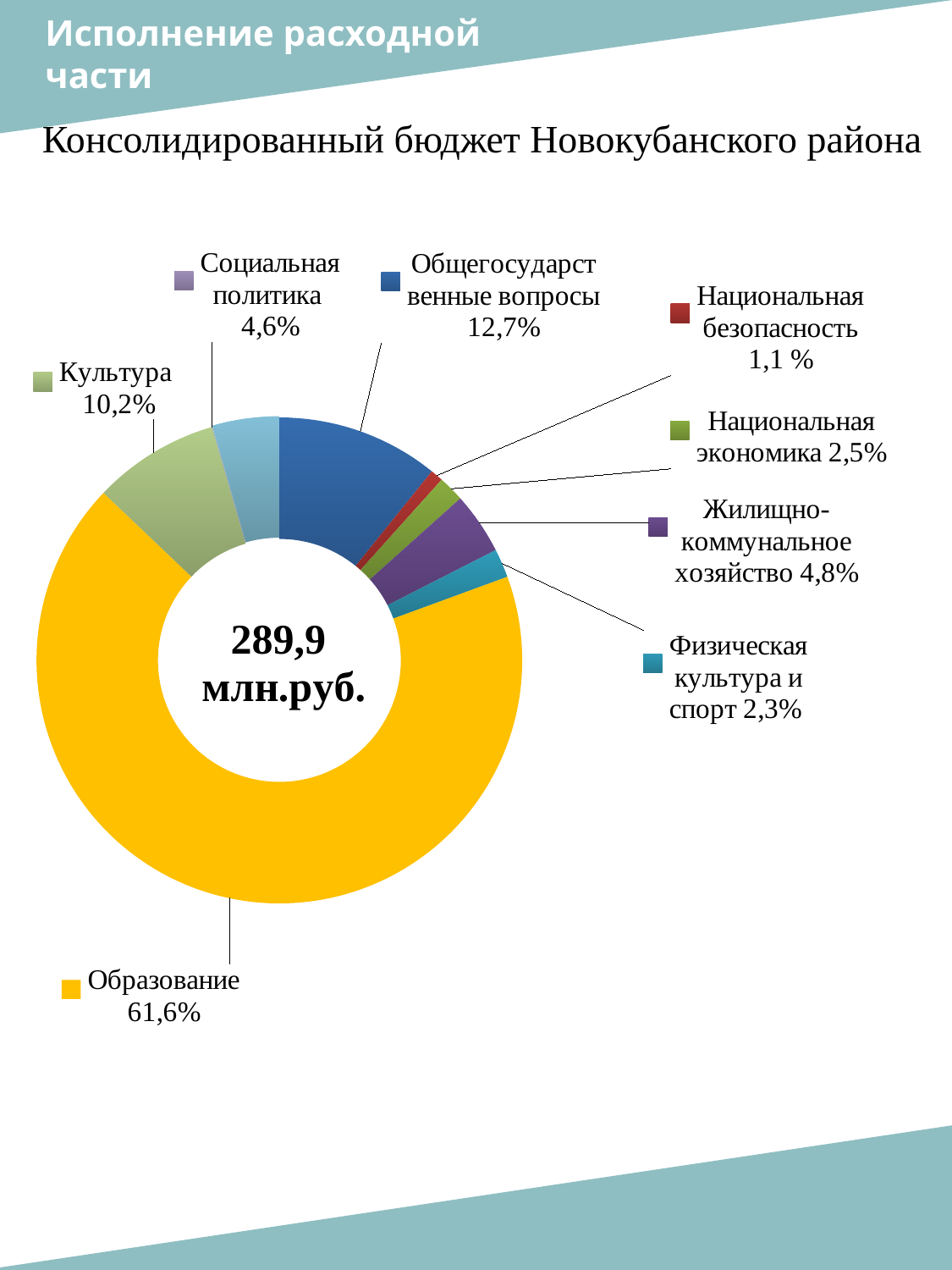
What colour is the segment for Образование? Yellow What total amount is shown in the centre of the chart? 289,9 млн.руб. How many categories are shown in the chart? 8 What kind of chart is shown on the slide? Pie (doughnut) chart What is the difference in percentage points between Общегосударственные вопросы and Культура? 2,5 What share of the budget goes to Культура? 10,2% What share of the budget goes to Жилищно-коммунальное хозяйство? 4,8% What share of the budget goes to Общегосударственные вопросы? 12,7% Which is larger: the share for Социальная политика or the share for Жилищно-коммунальное хозяйство? Жилищно-коммунальное хозяйство Which category has the largest share of the budget? Образование What share of the budget goes to Образование? 61,6% Which category has the smallest share of the budget? Национальная безопасность